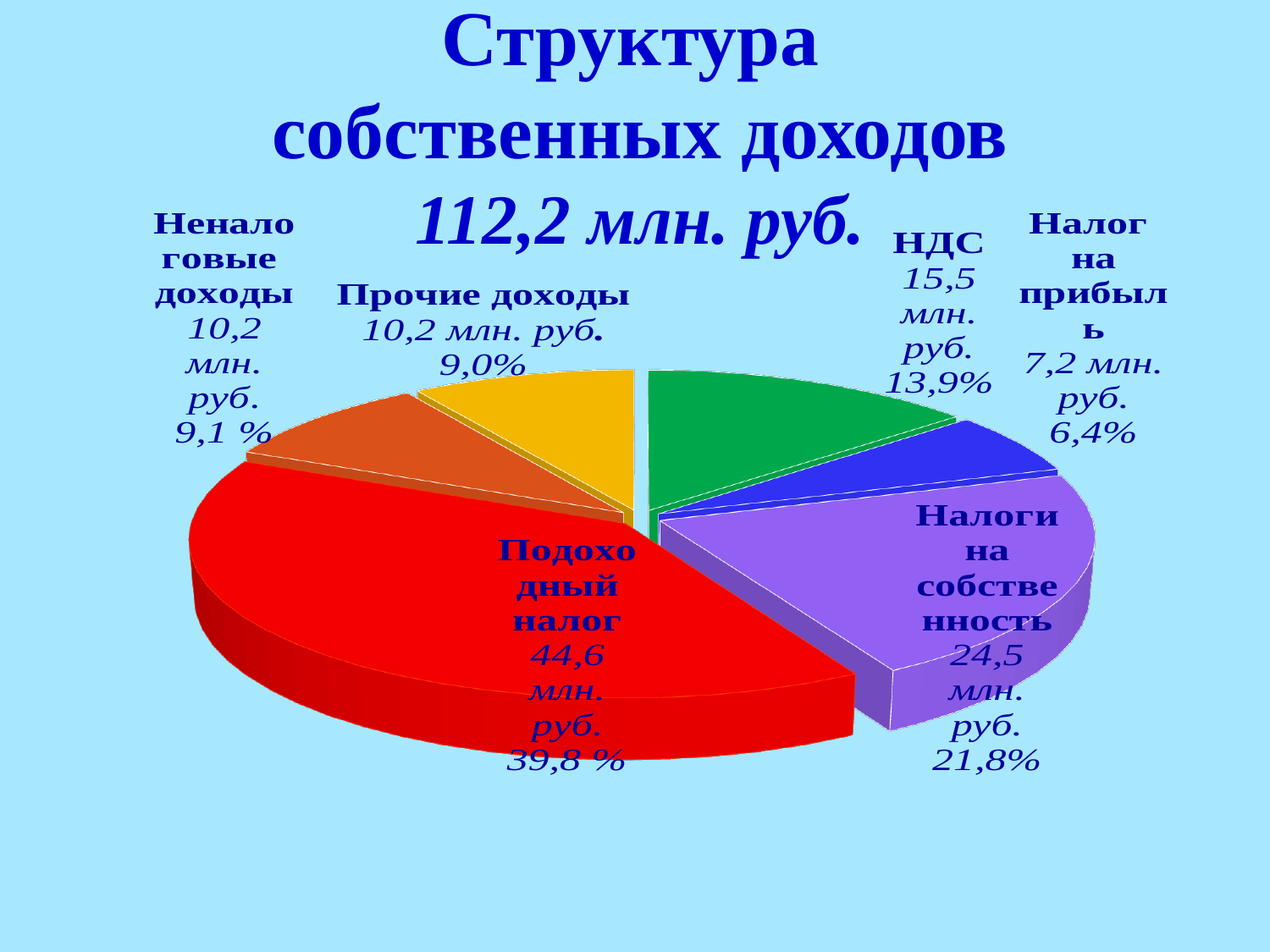
Which category has the largest slice of the pie? Подоходный налог What is the value for НДС in млн. руб.? 15,5 млн. руб. Which category has the smallest slice of the pie? Налог на прибыль What share of the pie does Налог на прибыль represent? 6,4% What is the value for Подоходный налог in млн. руб.? 44,6 млн. руб. What total amount is stated in the chart title? 112,2 млн. руб. What share of the pie does Неналоговые доходы represent? 9,1 % What share of the pie does Налоги на собственность represent? 21,8% What is the difference in млн. руб. between Подоходный налог and Налоги на собственность? 20,1 млн. руб. How many slices does the pie chart have? 6 What kind of chart is shown on the slide? pie chart Which is larger, НДС or Прочие доходы? НДС